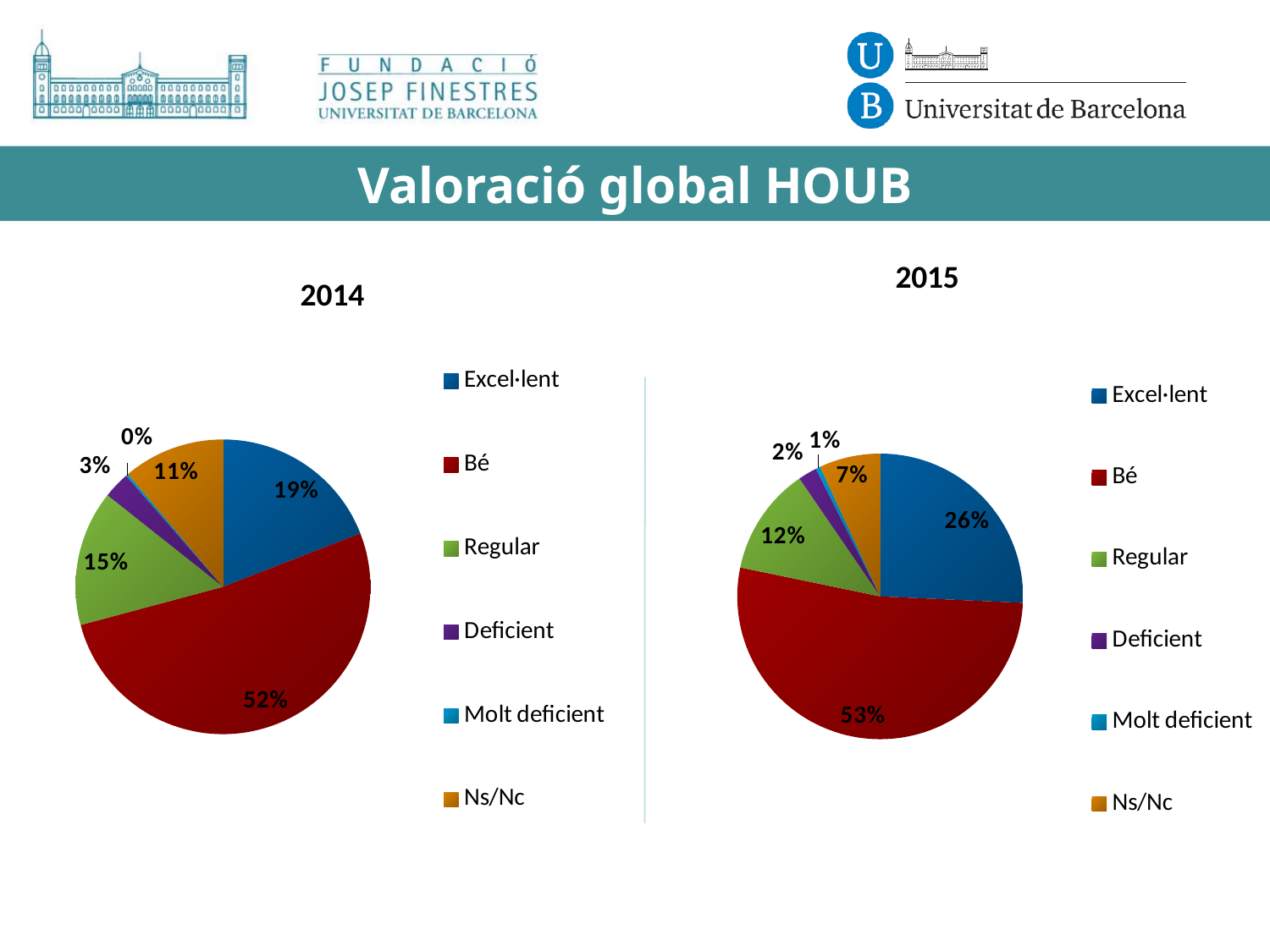
What type of chart is used for the 2015 data? Pie chart In the 2015 pie chart, which category has the smallest share? Molt deficient How many categories does the legend of the 2014 pie chart list? 6 In the 2014 pie chart, what share does Bé have? 52% In the 2014 pie chart, which category has the largest share? Bé What is the difference between the Excel·lent share in the 2015 chart and the Excel·lent share in the 2014 chart? 7% In the 2015 pie chart, what share does Ns/Nc have? 7% In the 2015 pie chart, which is larger: Regular or Ns/Nc? Regular In the 2015 pie chart, what share does Excel·lent have? 26% In the 2014 pie chart, what share does Regular have? 15% In the 2014 pie chart, what share does Deficient have? 3% In the 2014 pie chart, which category has the smallest share? Molt deficient